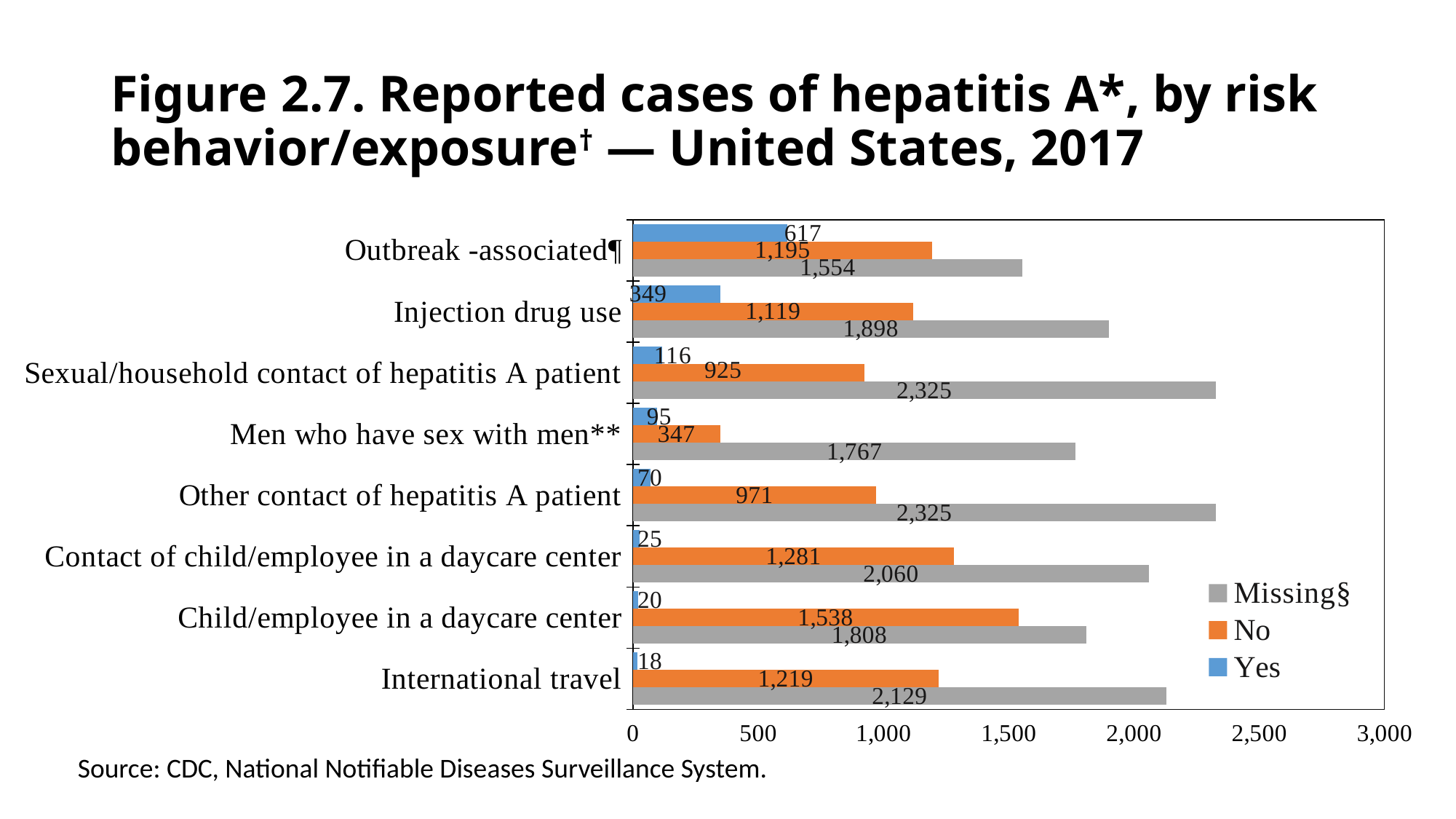
What kind of chart is shown on the slide? bar chart Which is larger: the 'Missing' value for International travel or the 'Missing' value for Men who have sex with men? International travel Which category has the lowest 'Yes' value? International travel What is the difference between the 'No' value for Child/employee in a daycare center and the 'No' value for Outbreak-associated? 343 Which category has the highest 'No' value? Child/employee in a daycare center How many risk behavior/exposure categories are plotted on the chart? 8 Which category has the highest 'Yes' value? Outbreak-associated How many series does the legend list? 3 What is the 'No' value for Men who have sex with men? 347 Which series is shown in orange in the legend? No What is the 'Missing' value for Injection drug use? 1,898 What is the 'Yes' value for Outbreak-associated? 617